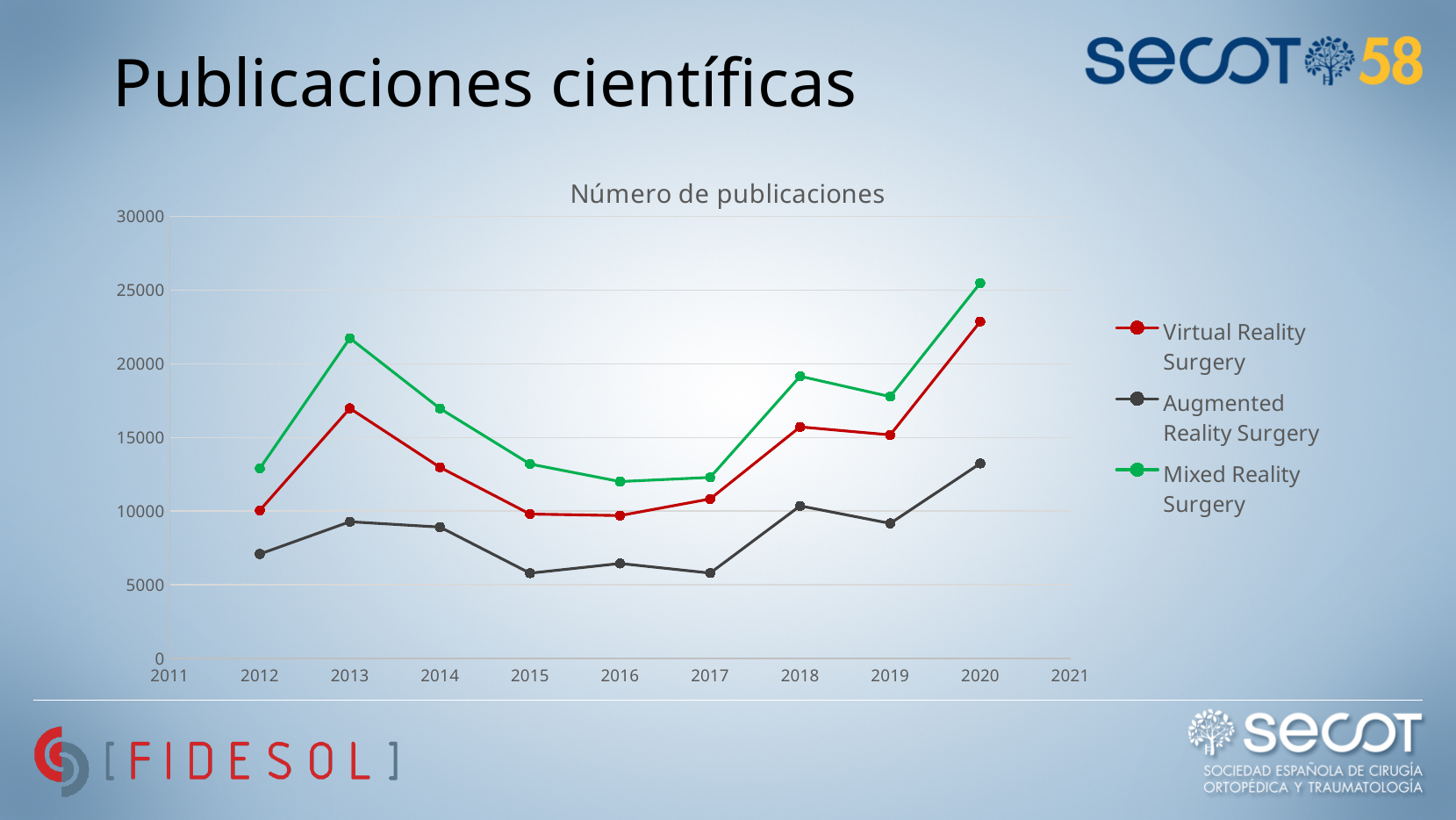
How many years have plotted data points for each series? 9 In which year does Augmented Reality Surgery reach its highest value? 2020 How many series does the legend list? 3 What is the title of the chart? Número de publicaciones In which year does Mixed Reality Surgery reach its highest value? 2020 Is the value for Mixed Reality Surgery in 2020 greater or less than 25000? greater What kind of chart is shown on the slide? line chart In 2013, which series has the higher value, Mixed Reality Surgery or Virtual Reality Surgery? Mixed Reality Surgery Which series is drawn in green? Mixed Reality Surgery Is the value for Virtual Reality Surgery in 2020 greater or less than 25000? less Does the Virtual Reality Surgery series rise or fall from 2017 to 2020? rise Is the value for Augmented Reality Surgery in 2020 greater or less than 10000? greater